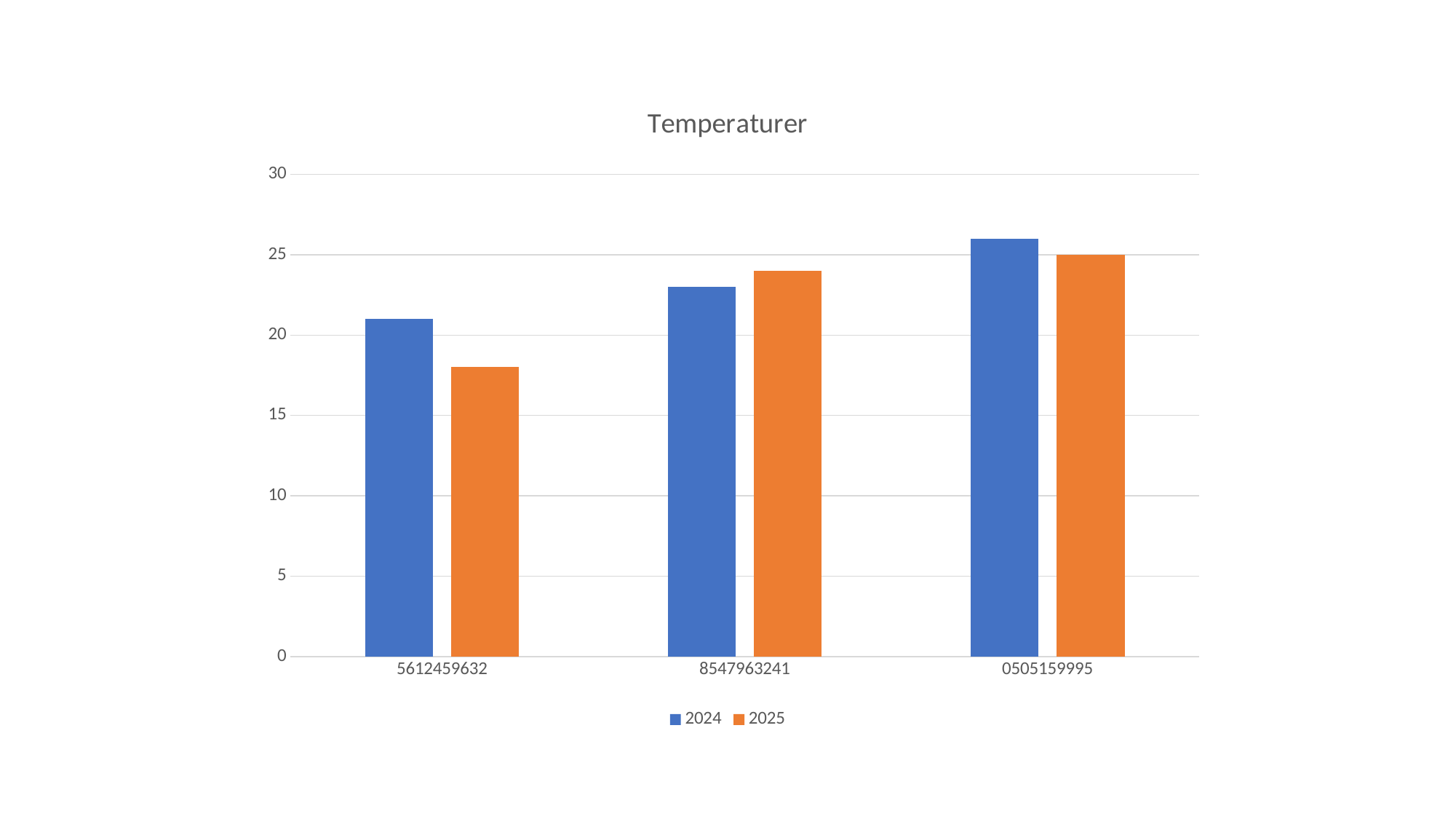
Is the value for 2024 in category 8547963241 greater or less than 25? less How many series does the legend list? 2 In category 5612459632, which series has the larger value, 2024 or 2025? 2024 What is the value for 2025 in category 0505159995? 25 Which category has the highest value for the 2024 series? 0505159995 What kind of chart is shown on the slide? bar chart What is the title of the chart? Temperaturer Do the values for the 2024 series rise or fall from left to right along the x axis? rise How many categories are shown on the x axis? 3 Is the value for 2024 in category 0505159995 greater or less than 25? greater Is the value for 2025 in category 5612459632 greater or less than 20? less Which category has the lowest value for the 2025 series? 5612459632